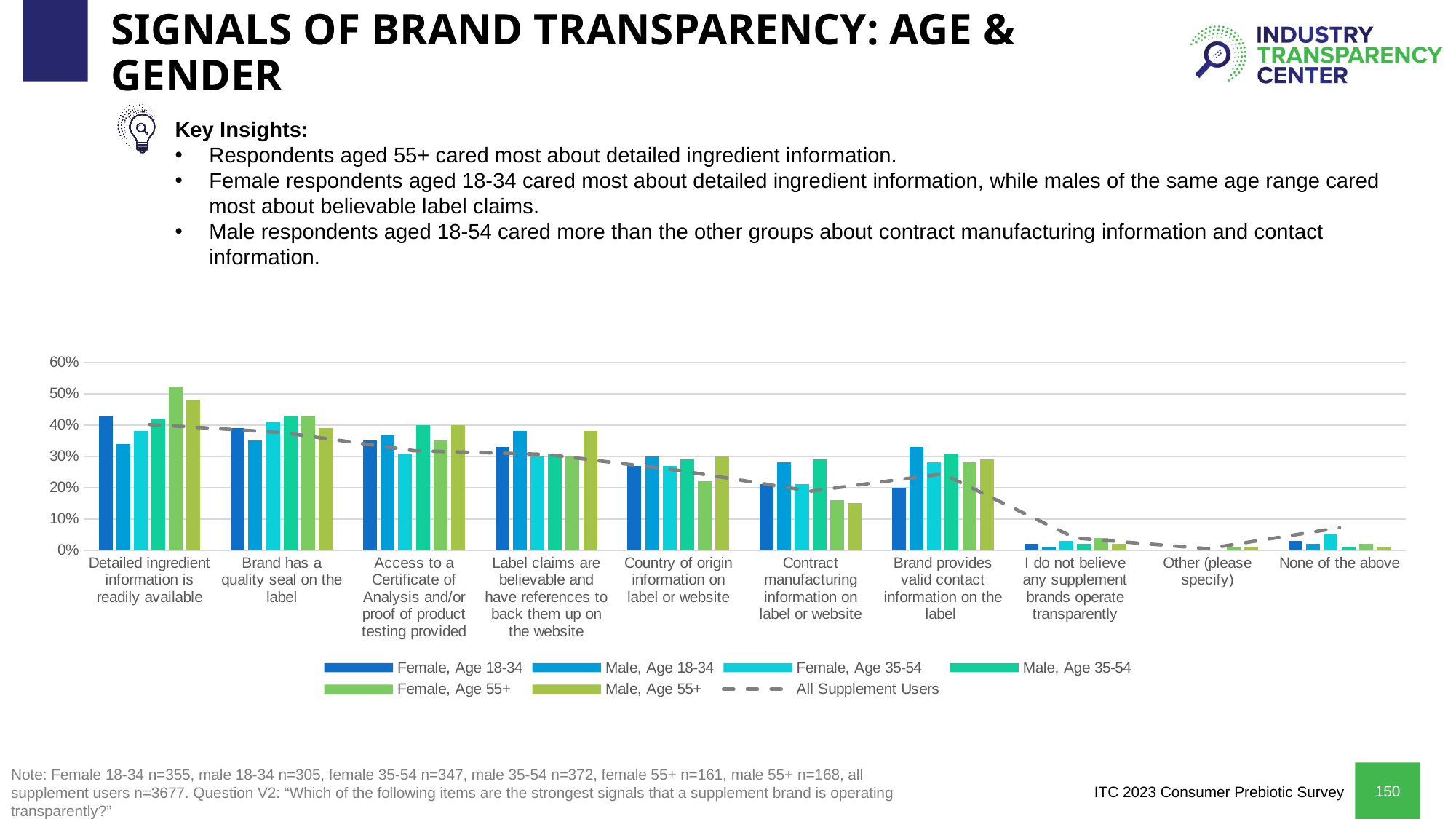
Which legend entry is represented by the dashed grey line in the chart? All Supplement Users Is the value for Male, Age 55+ in 'Contract manufacturing information on label or website' greater or less than 20%? less How many categories are shown along the x axis of the chart? 10 Which series has the highest value for 'Detailed ingredient information is readily available'? Female, Age 55+ How many entries does the chart's legend list? 7 For 'Detailed ingredient information is readily available', which is larger: Female, Age 55+ or Male, Age 55+? Female, Age 55+ What kind of chart is shown on the slide? combination bar and line chart Is the value for Male, Age 18-34 in 'Brand provides valid contact information on the label' greater or less than 30%? greater Is the value for Female, Age 55+ in 'Detailed ingredient information is readily available' greater or less than 50%? greater Which series has the highest value for 'Brand provides valid contact information on the label'? Male, Age 18-34 For 'Brand provides valid contact information on the label', which is larger: Female, Age 18-34 or Male, Age 18-34? Male, Age 18-34